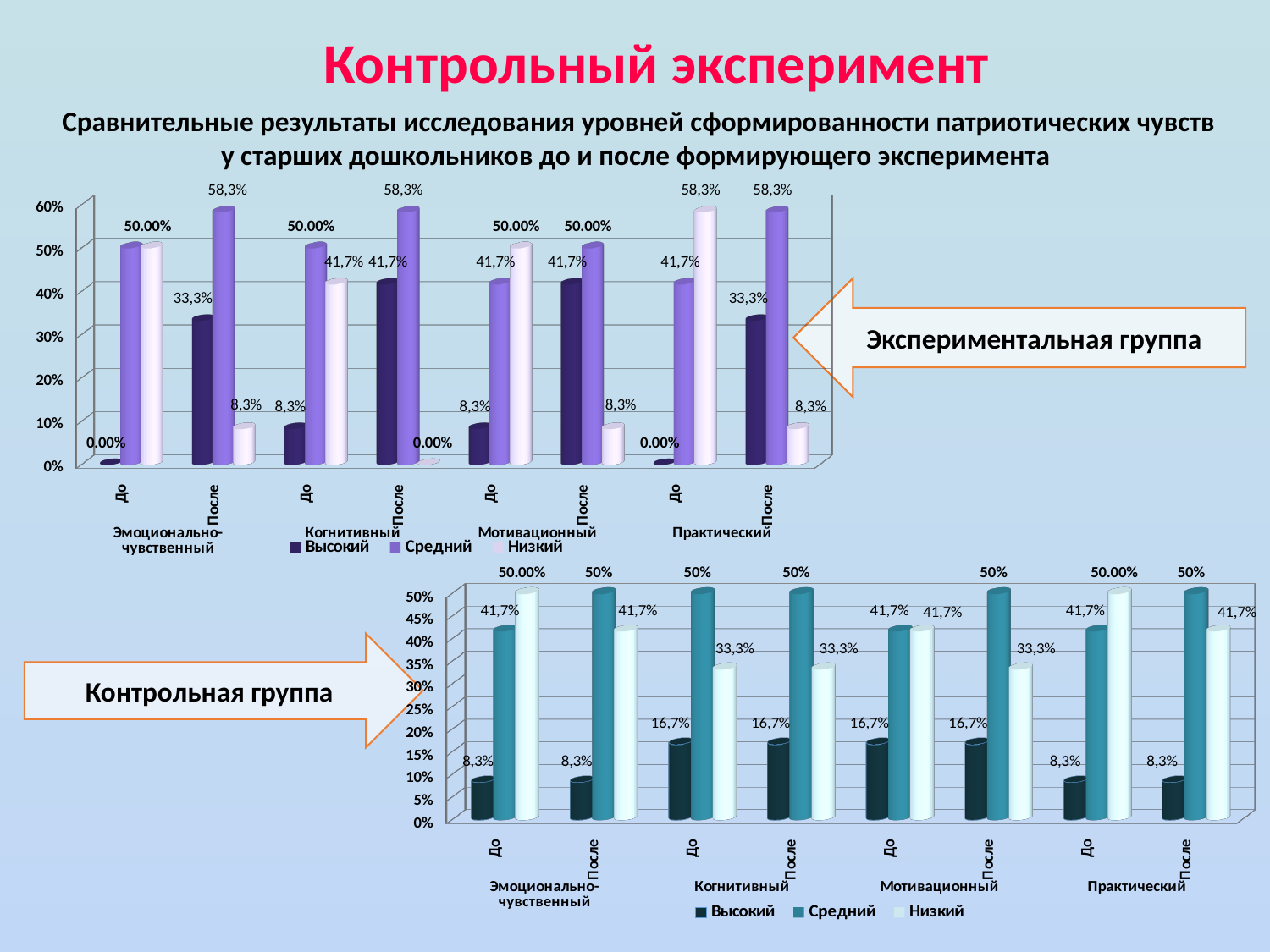
In the Экспериментальная группа chart, what is the value of Средний for Мотивационный До? 41,7% In the Экспериментальная группа chart, what is the value of Низкий for Практический До? 58,3% In the Экспериментальная группа chart, what is the difference between Высокий for Когнитивный После and Высокий for Когнитивный До? 33,4% What type of chart is the Экспериментальная группа chart? Bar chart How many series does the legend of the Контрольная группа chart list? 3 In the Контрольная группа chart, what is the difference between Средний and Низкий for Мотивационный После? 16,7% In the Контрольная группа chart, what is the value of Низкий for Практический После? 41,7% In the Контрольная группа chart, which series has the lowest value for Эмоционально-чувственный До? Высокий How many До/После bar groups are shown in the Экспериментальная группа chart? 8 In the Экспериментальная группа chart, which is larger for Мотивационный После: Средний or Низкий? Средний In the Экспериментальная группа chart, what is the value of Высокий for Эмоционально-чувственный После? 33,3% In the Контрольная группа chart, what is the value of Высокий for Когнитивный До? 16,7%